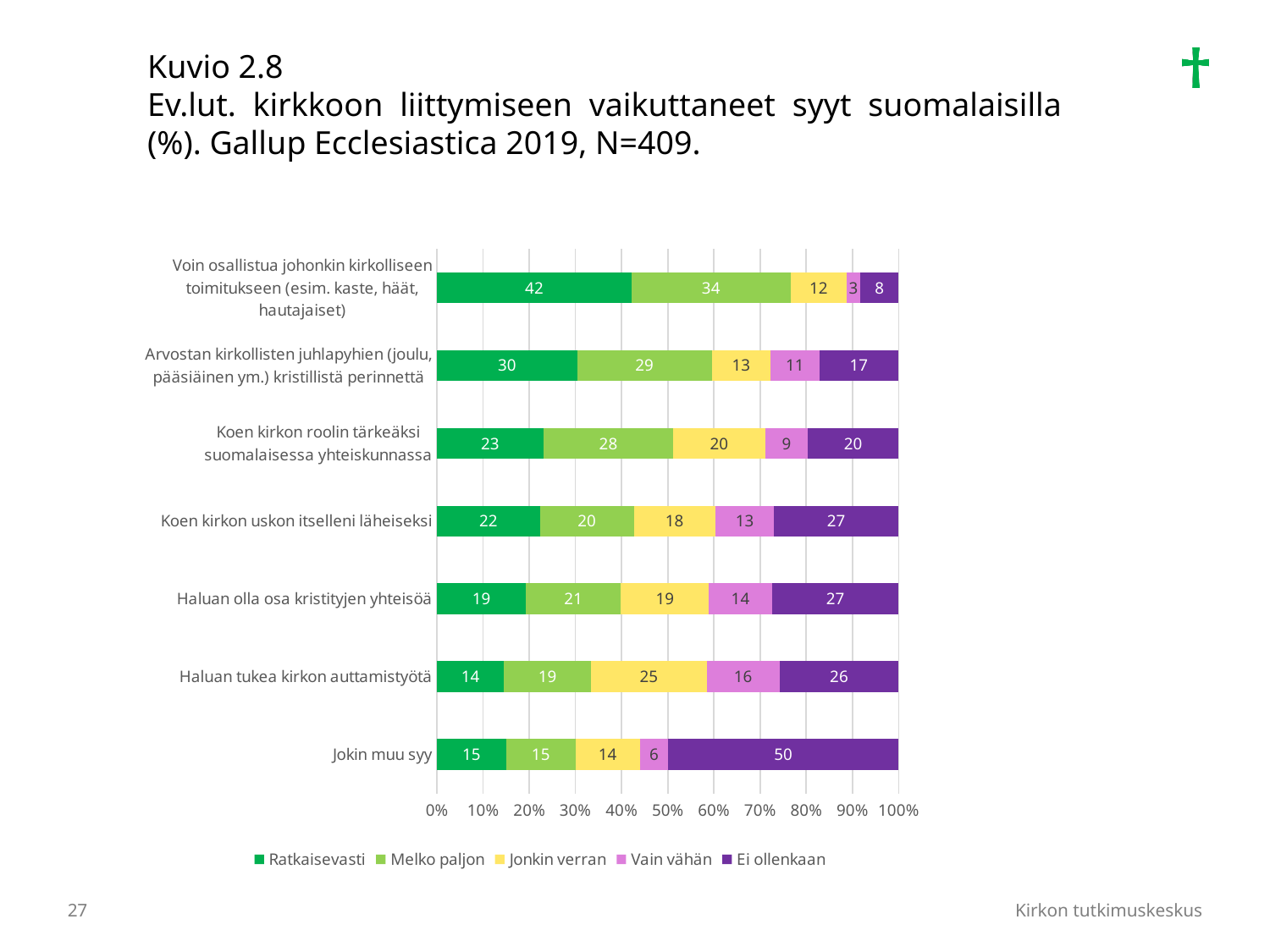
What is the difference between the "Ei ollenkaan" value for "Jokin muu syy" and for "Koen kirkon uskon itselleni läheiseksi"? 23 What is the value of "Jonkin verran" for "Koen kirkon roolin tärkeäksi suomalaisessa yhteiskunnassa"? 20 How many series does the legend list? 5 What is the value of "Ei ollenkaan" for "Haluan tukea kirkon auttamistyötä"? 26 What is the value of "Ratkaisevasti" for "Jokin muu syy"? 15 What is the total of the stacked bar for "Voin osallistua johonkin kirkolliseen toimitukseen (esim. kaste, häät, hautajaiset)"? 99 How many categories are shown on the chart? 7 Which series is shown in dark purple in the legend? Ei ollenkaan Which is larger: the "Melko paljon" value for "Arvostan kirkollisten juhlapyhien (joulu, pääsiäinen ym.) kristillistä perinnettä" or for "Haluan olla osa kristityjen yhteisöä"? Arvostan kirkollisten juhlapyhien (joulu, pääsiäinen ym.) kristillistä perinnettä Which category has the highest "Ratkaisevasti" value? Voin osallistua johonkin kirkolliseen toimitukseen (esim. kaste, häät, hautajaiset) What kind of chart is shown on the slide? Stacked bar chart Which category has the lowest "Ei ollenkaan" value? Voin osallistua johonkin kirkolliseen toimitukseen (esim. kaste, häät, hautajaiset)